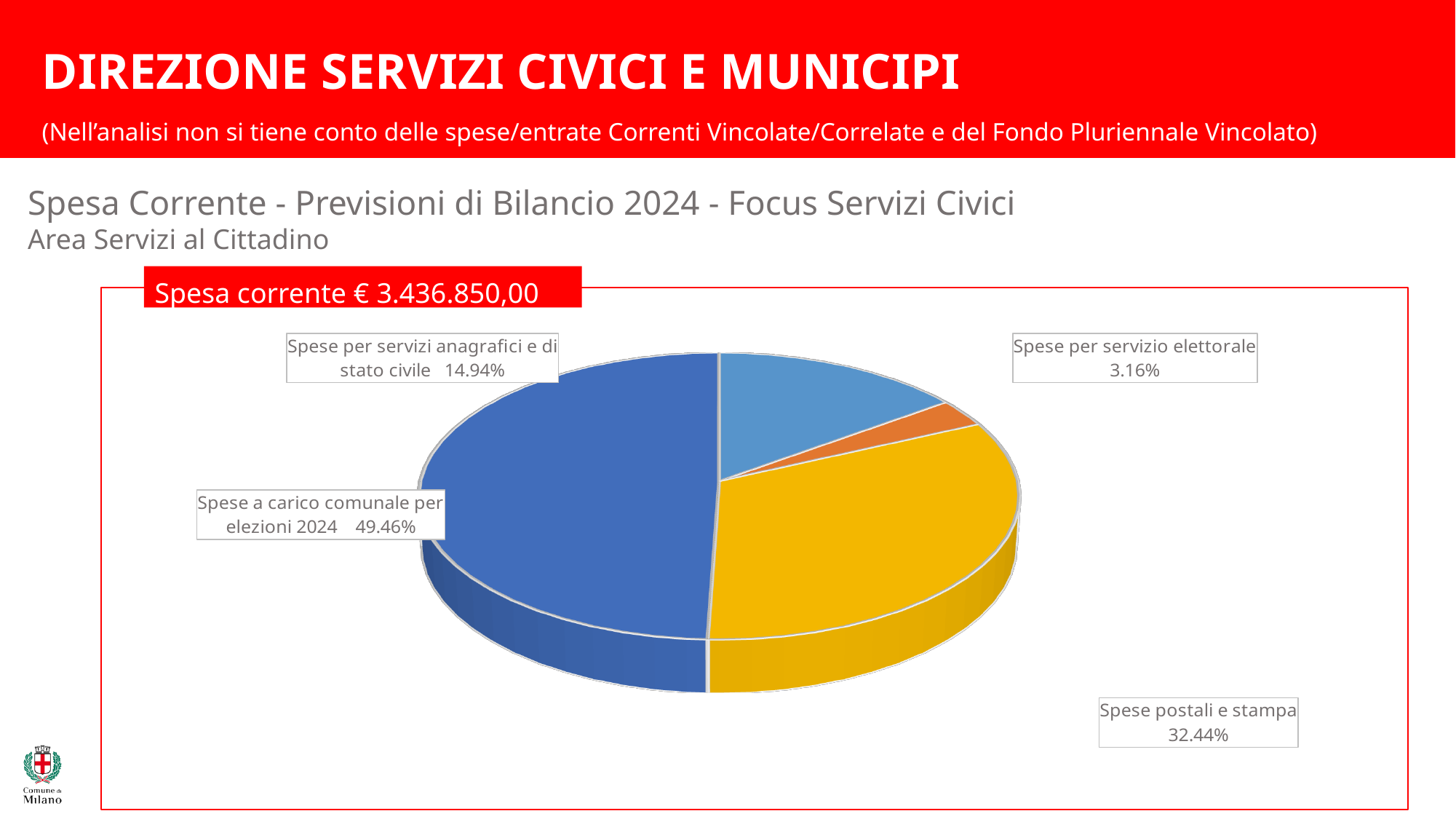
What share of the pie is 'Spese per servizi anagrafici e di stato civile'? 14.94% What share of the pie is 'Spese per servizio elettorale'? 3.16% Which category has the largest slice of the pie? Spese a carico comunale per elezioni 2024 Which is larger: 'Spese per servizi anagrafici e di stato civile' or 'Spese per servizio elettorale'? Spese per servizi anagrafici e di stato civile What is the difference in percentage points between 'Spese a carico comunale per elezioni 2024' and 'Spese postali e stampa'? 17.02 What kind of chart is shown on the slide? Pie chart Which category has the smallest slice of the pie? Spese per servizio elettorale How many categories are shown in the pie chart? 4 What share of the pie is 'Spese postali e stampa'? 32.44% What colour is the slice for 'Spese postali e stampa'? Yellow What total current expenditure (Spesa corrente) is stated in the red box above the chart? € 3.436.850,00